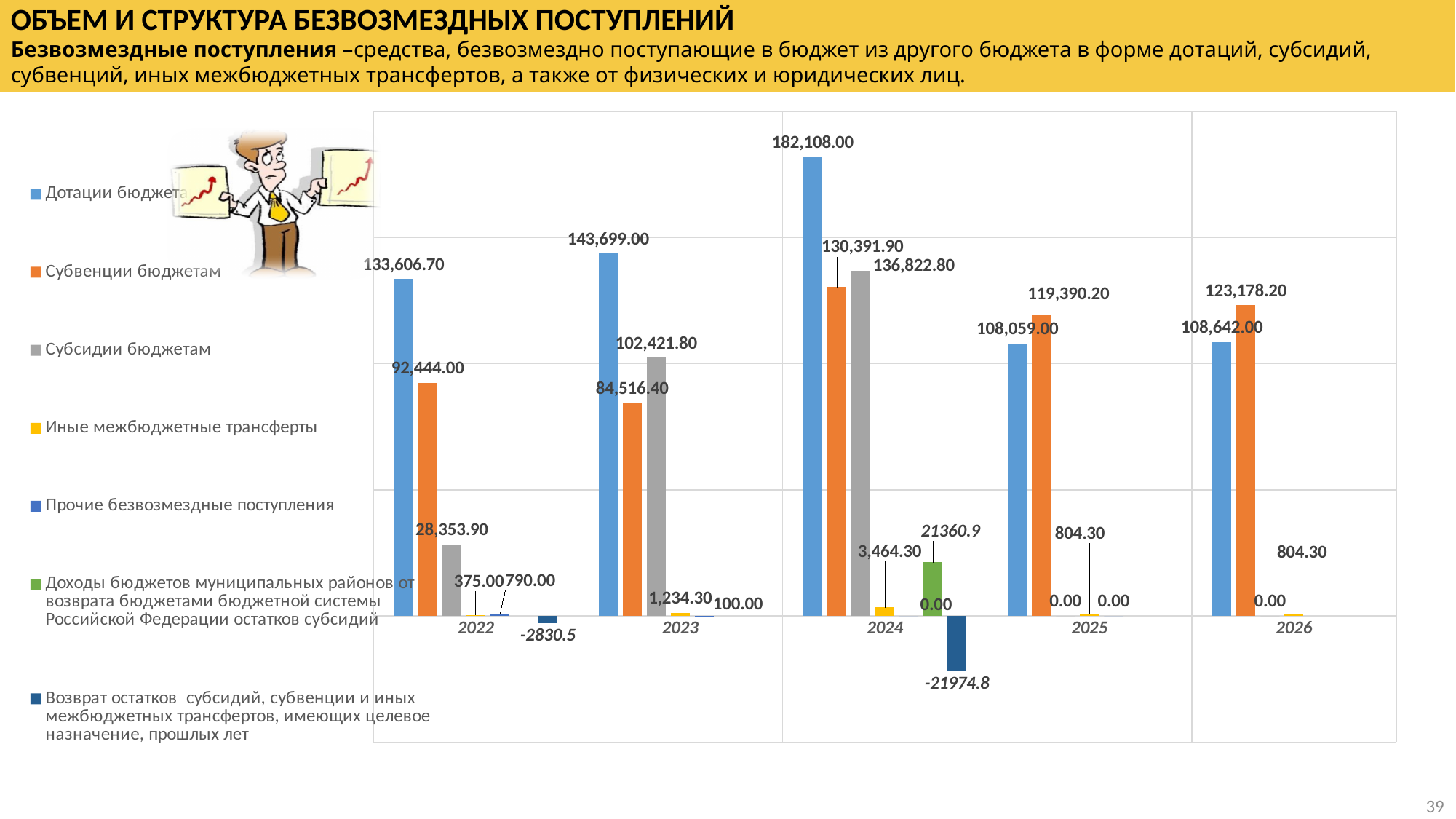
Does Дотации бюджетам rise or fall from 2022 to 2024? Rises What is the value of Субсидии бюджетам in 2023? 102,421.80 How many years are shown on the x axis? 5 How many series does the legend list? 7 What is the value of Дотации бюджетам in 2024? 182,108.00 In 2025, which is larger: Дотации бюджетам or Субвенции бюджетам? Субвенции бюджетам In which year is Дотации бюджетам the highest? 2024 What is the difference between Дотации бюджетам in 2023 and in 2022? 10,092.30 What is the value of Субвенции бюджетам in 2025? 119,390.20 What is the value of Возврат остатков субсидий, субвенции и иных межбюджетных трансфертов in 2024? -21974.8 What kind of chart is shown on the slide? Bar chart